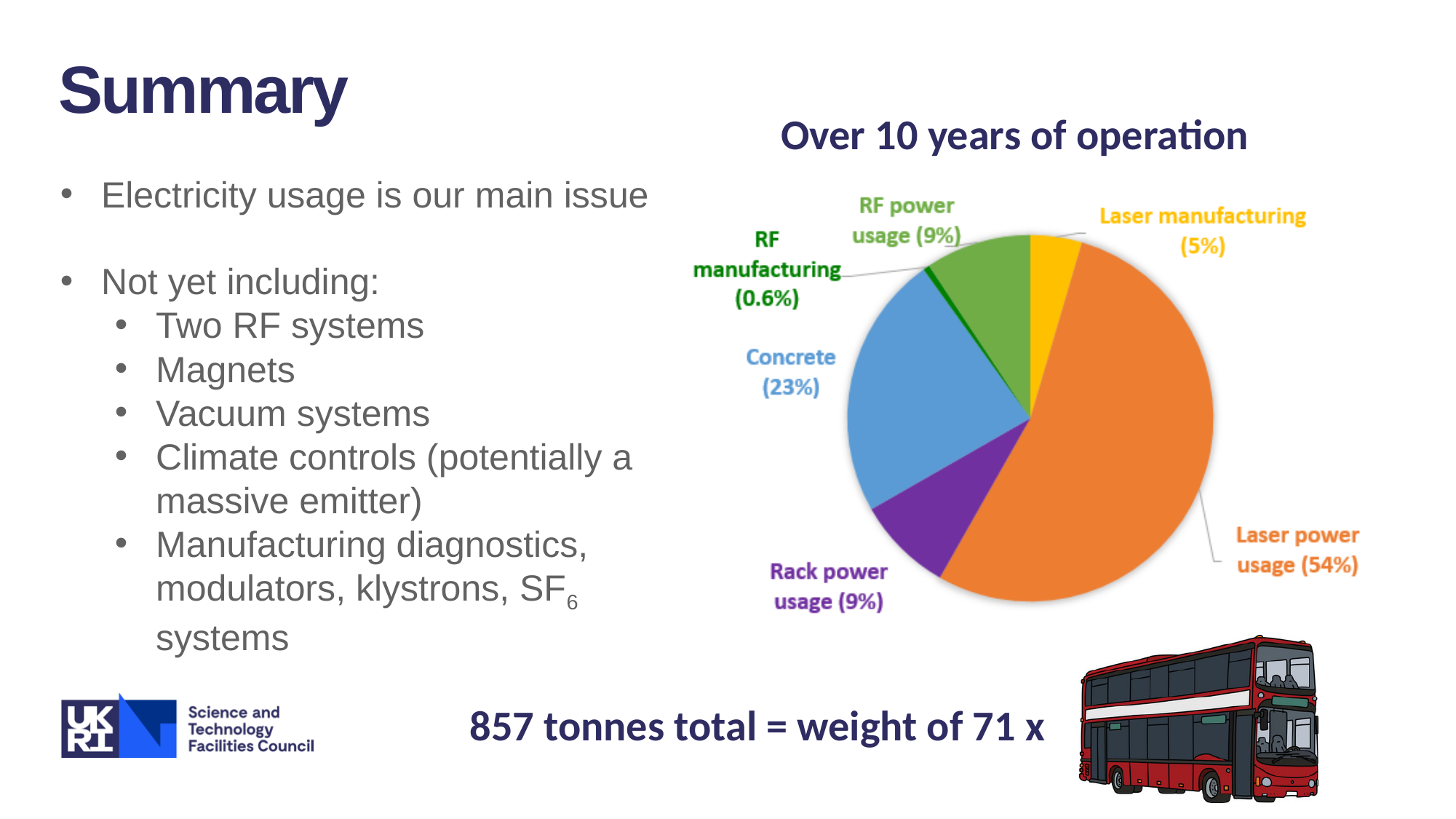
Which category has the largest slice of the pie? Laser power usage Which is larger, the share for Concrete or the share for Laser manufacturing? Concrete What share of the pie does Laser power usage account for? 54% What kind of chart is shown on the slide? Pie chart What is the difference in percentage points between Laser power usage and Concrete? 31 Which category has the smallest slice of the pie? RF manufacturing What share of the pie does RF manufacturing account for? 0.6% What share of the pie does Concrete account for? 23% How many categories are shown in the pie chart? 6 What is the title shown above the pie chart? Over 10 years of operation What colour is the Concrete slice of the pie? Blue